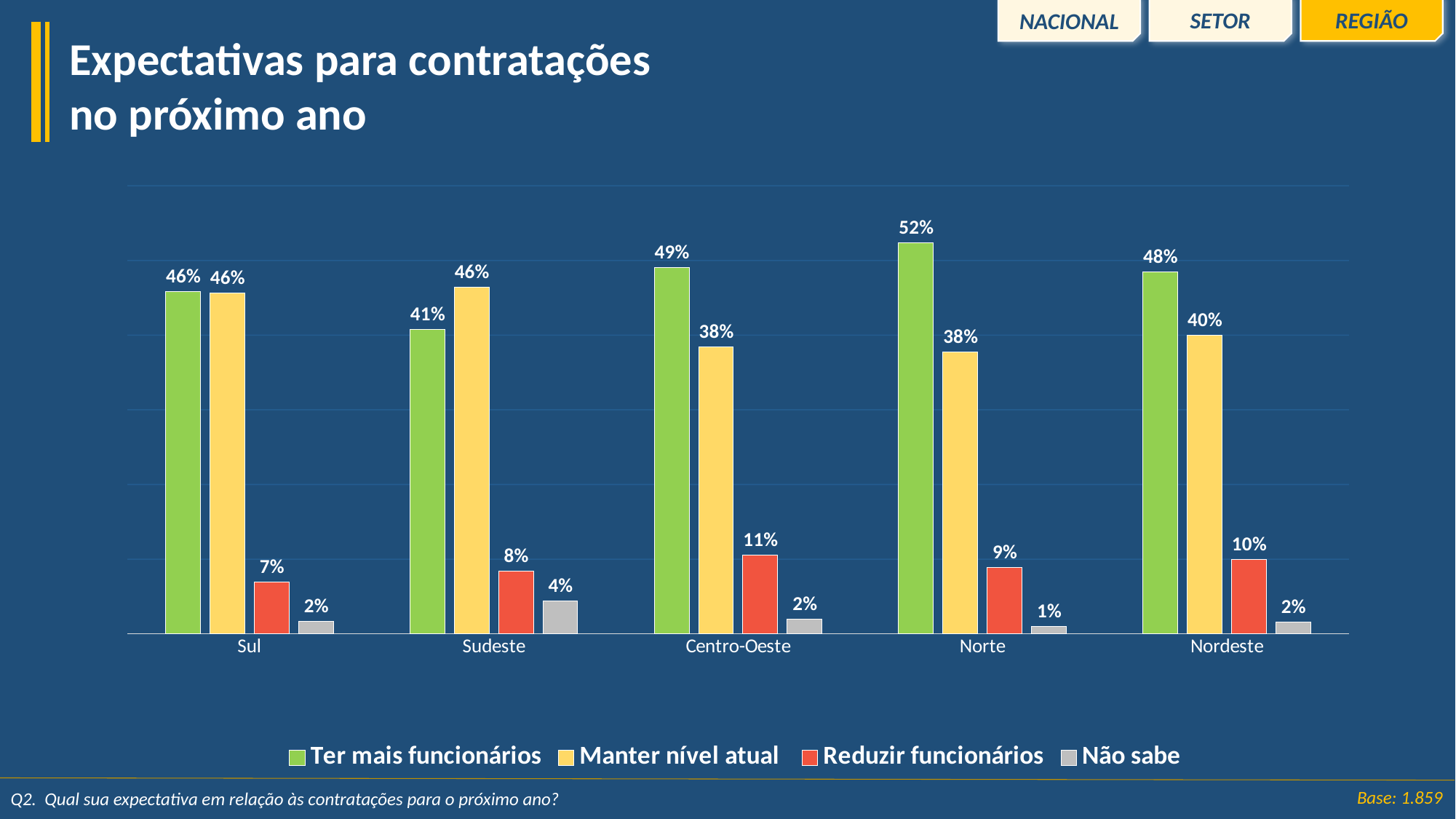
Which region has the highest value for "Ter mais funcionários"? Norte What is the value for "Ter mais funcionários" in Norte? 52% How many series does the legend list? 4 What is the value for "Não sabe" in Sudeste? 4% Which is larger in Sudeste: "Ter mais funcionários" or "Manter nível atual"? Manter nível atual Which region has the lowest value for "Não sabe"? Norte Which colour represents "Reduzir funcionários" in the legend? Red How many regions are shown on the x axis? 5 What kind of chart is shown on the slide? Bar chart What is the difference between "Ter mais funcionários" and "Manter nível atual" in Norte? 14% What is the value for "Reduzir funcionários" in Centro-Oeste? 11% What is the value for "Manter nível atual" in Nordeste? 40%